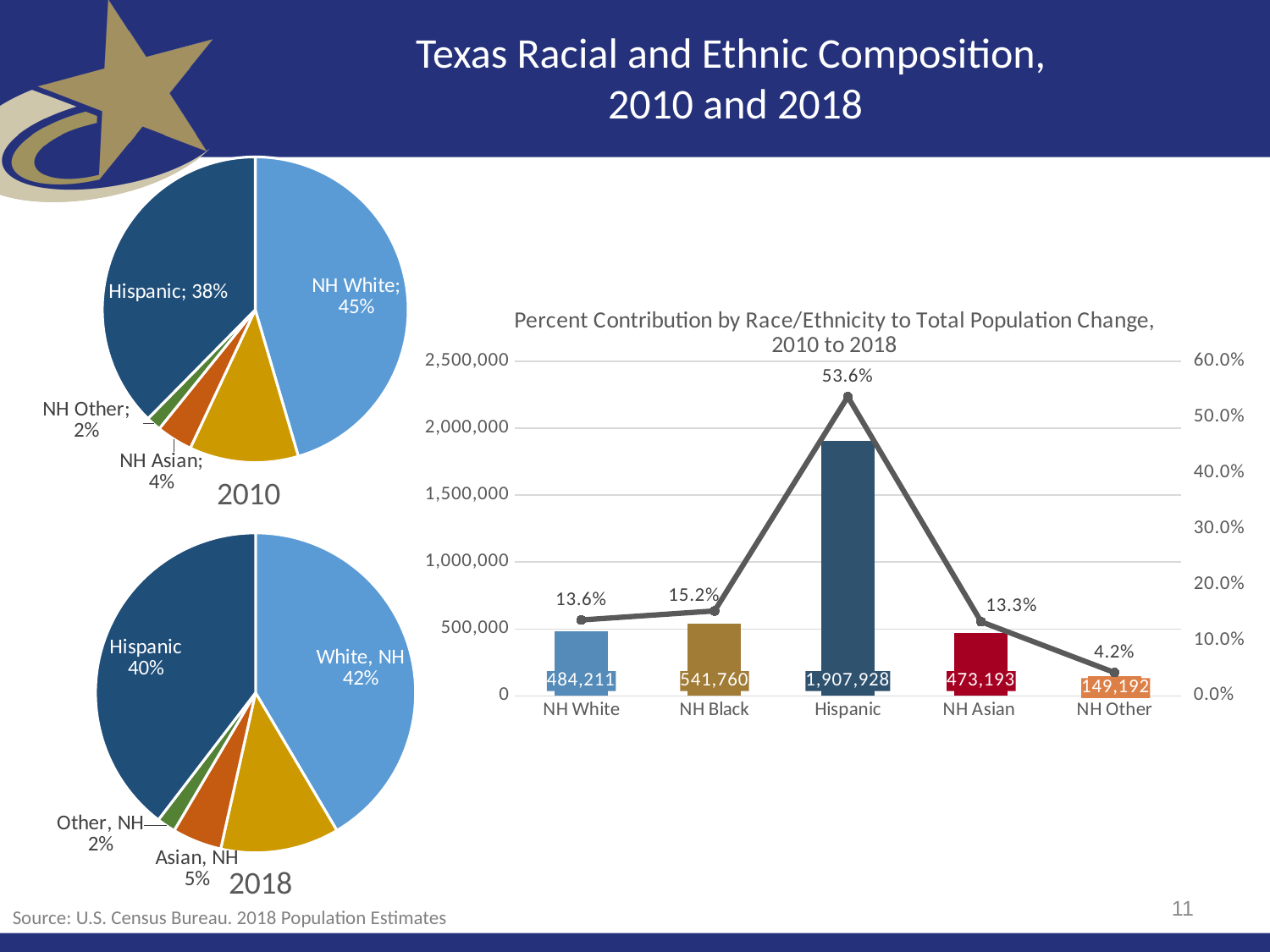
In the 'Percent Contribution by Race/Ethnicity to Total Population Change, 2010 to 2018' chart, what is the difference between the NH White and NH Asian population change values? 11,018 In the 'Percent Contribution by Race/Ethnicity to Total Population Change, 2010 to 2018' chart, which category has the lowest population change? NH Other In the 2010 pie chart, what share of the population is NH White? 45% In the 2010 pie chart, what share of the population is Hispanic? 38% In the 2018 pie chart, which is larger, the White, NH slice or the Hispanic slice? White, NH In the 2018 pie chart, what share of the population is Asian, NH? 5% In the 'Percent Contribution by Race/Ethnicity to Total Population Change, 2010 to 2018' chart, what percent contribution is shown for NH Asian? 13.3% In the 'Percent Contribution by Race/Ethnicity to Total Population Change, 2010 to 2018' chart, what is the population change value for NH Black? 541,760 In the 'Percent Contribution by Race/Ethnicity to Total Population Change, 2010 to 2018' chart, what is the population change value for Hispanic? 1,907,928 In the 2010 pie chart, what is the difference between the NH White share and the Hispanic share? 7% In the 2018 pie chart, what share of the population is Hispanic? 40% In the 'Percent Contribution by Race/Ethnicity to Total Population Change, 2010 to 2018' chart, how many categories are shown on the x axis? 5